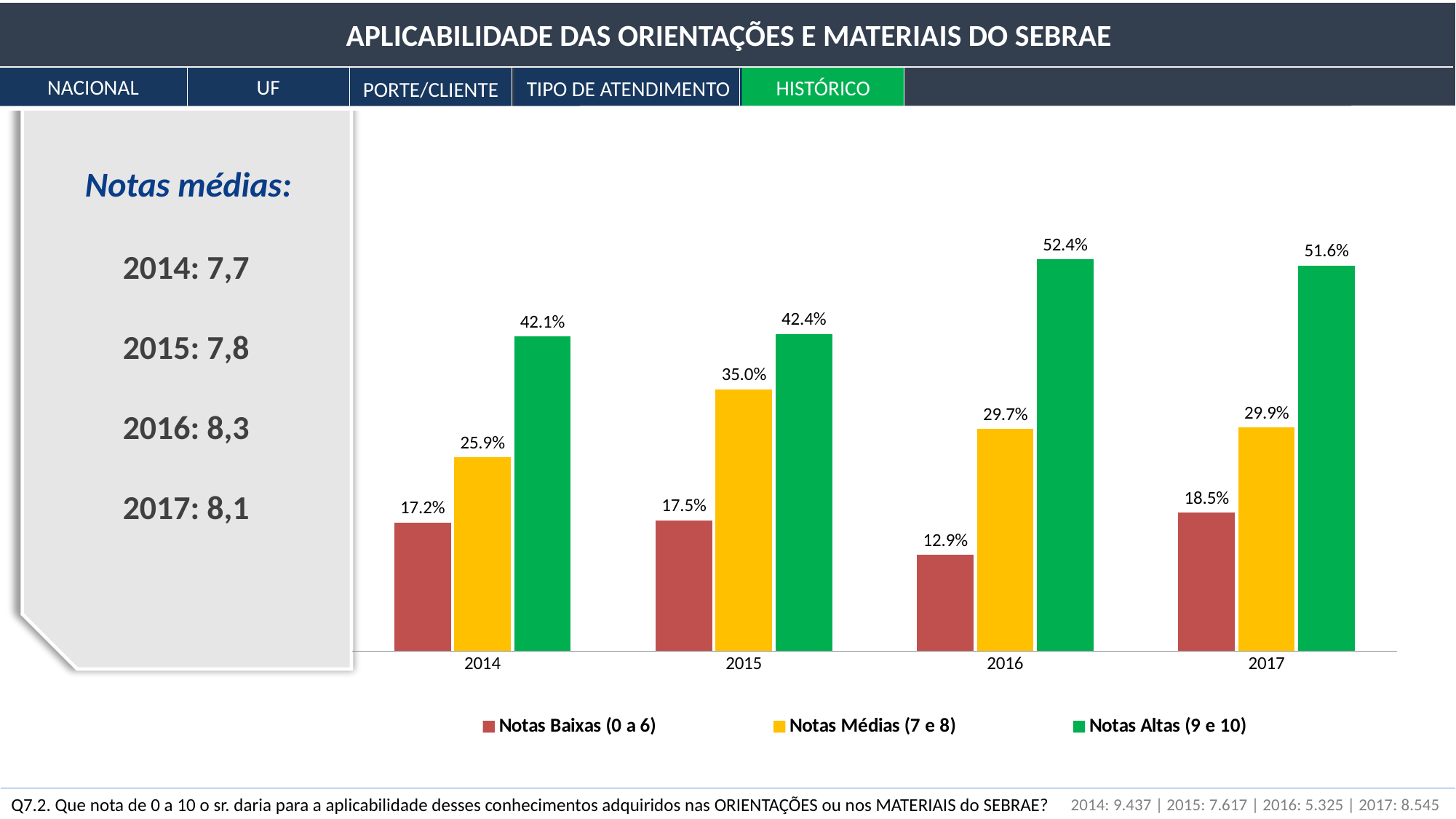
What is the value for Notas Médias (7 e 8) in 2015? 35.0% Does the Notas Altas (9 e 10) value rise or fall from 2014 to 2016? Rise What is the value for Notas Altas (9 e 10) in 2016? 52.4% What is the value for Notas Baixas (0 a 6) in 2014? 17.2% In which year is the Notas Baixas (0 a 6) value lowest? 2016 Which colour represents Notas Altas (9 e 10) in the chart? Green How many series does the chart legend list? 3 How many years are shown on the x axis of the chart? 4 In which year is the Notas Altas (9 e 10) value highest? 2016 What is the difference between the Notas Altas (9 e 10) values for 2016 and 2015? 10.0% What kind of chart is shown on the slide? Bar chart Which is larger: Notas Médias (7 e 8) in 2015 or Notas Médias (7 e 8) in 2017? 2015